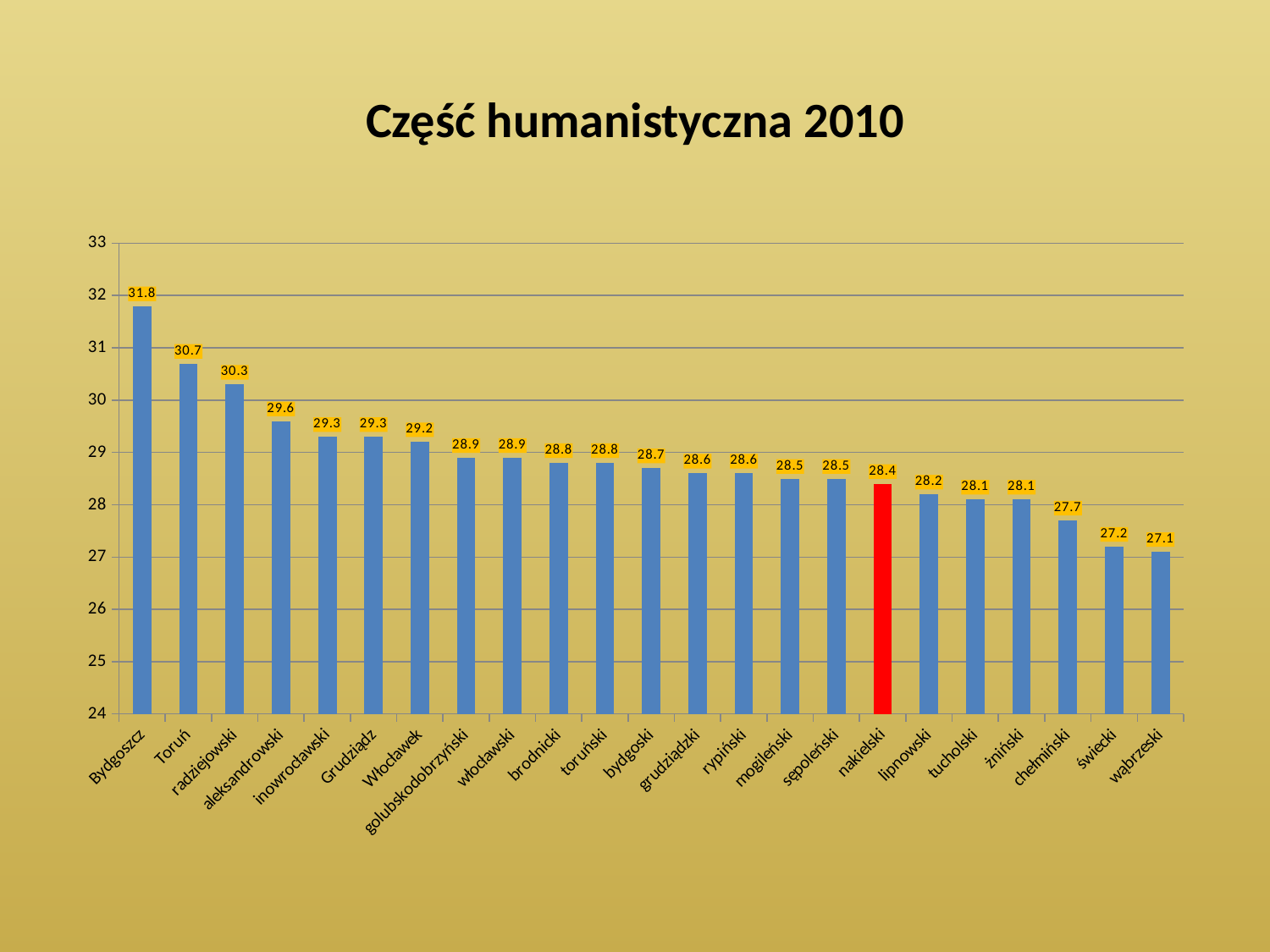
What kind of chart is shown on the slide? bar chart What is the difference between the values for Bydgoszcz and Toruń? 1.1 What is the difference between the values for nakielski and wąbrzeski? 1.3 What is the value for chełmiński? 27.7 How many categories are shown on the x axis? 23 What is the value for Bydgoszcz? 31.8 Which category has the lowest value? wąbrzeski Is the value for świecki greater or less than 28? less Which category has the highest value? Bydgoszcz What is the value for nakielski? 28.4 Which bar is coloured red instead of blue? nakielski Which is larger, the value for radziejowski or the value for aleksandrowski? radziejowski